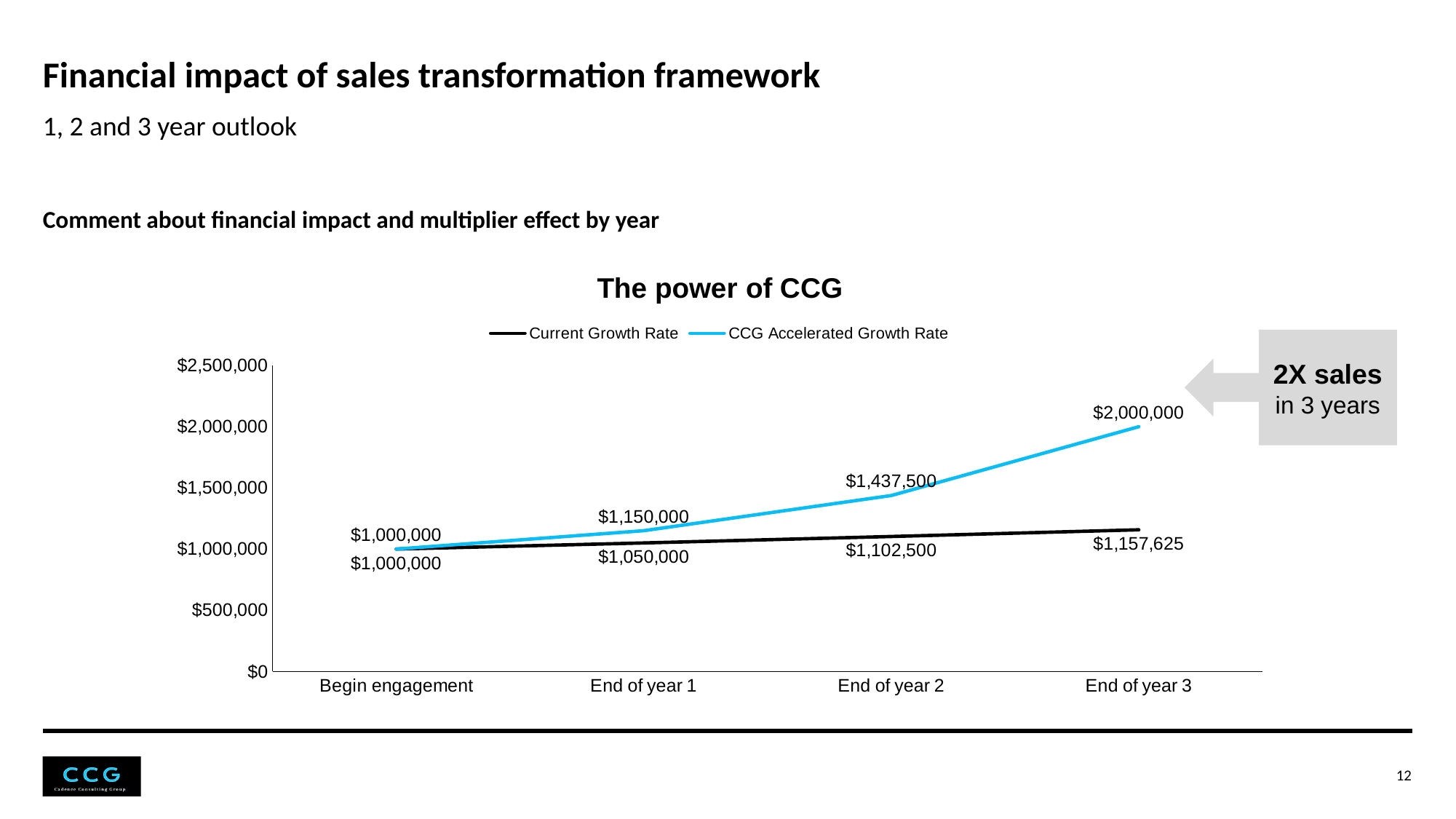
What is the value of the CCG Accelerated Growth Rate series at End of year 1? $1,150,000 How many points are plotted along the x axis? 4 What is the value of the Current Growth Rate series at End of year 2? $1,102,500 What is the value of the Current Growth Rate series at End of year 3? $1,157,625 At which point is the CCG Accelerated Growth Rate series highest? End of year 3 What is the value of the CCG Accelerated Growth Rate series at End of year 3? $2,000,000 At which point is the Current Growth Rate series lowest? Begin engagement What kind of chart is shown? Line chart How many series does the legend list? 2 What is the difference between the CCG Accelerated Growth Rate and the Current Growth Rate at End of year 3? $842,375 At End of year 2, which series has the larger value, Current Growth Rate or CCG Accelerated Growth Rate? CCG Accelerated Growth Rate Does the CCG Accelerated Growth Rate series rise or fall from Begin engagement to End of year 3? Rise